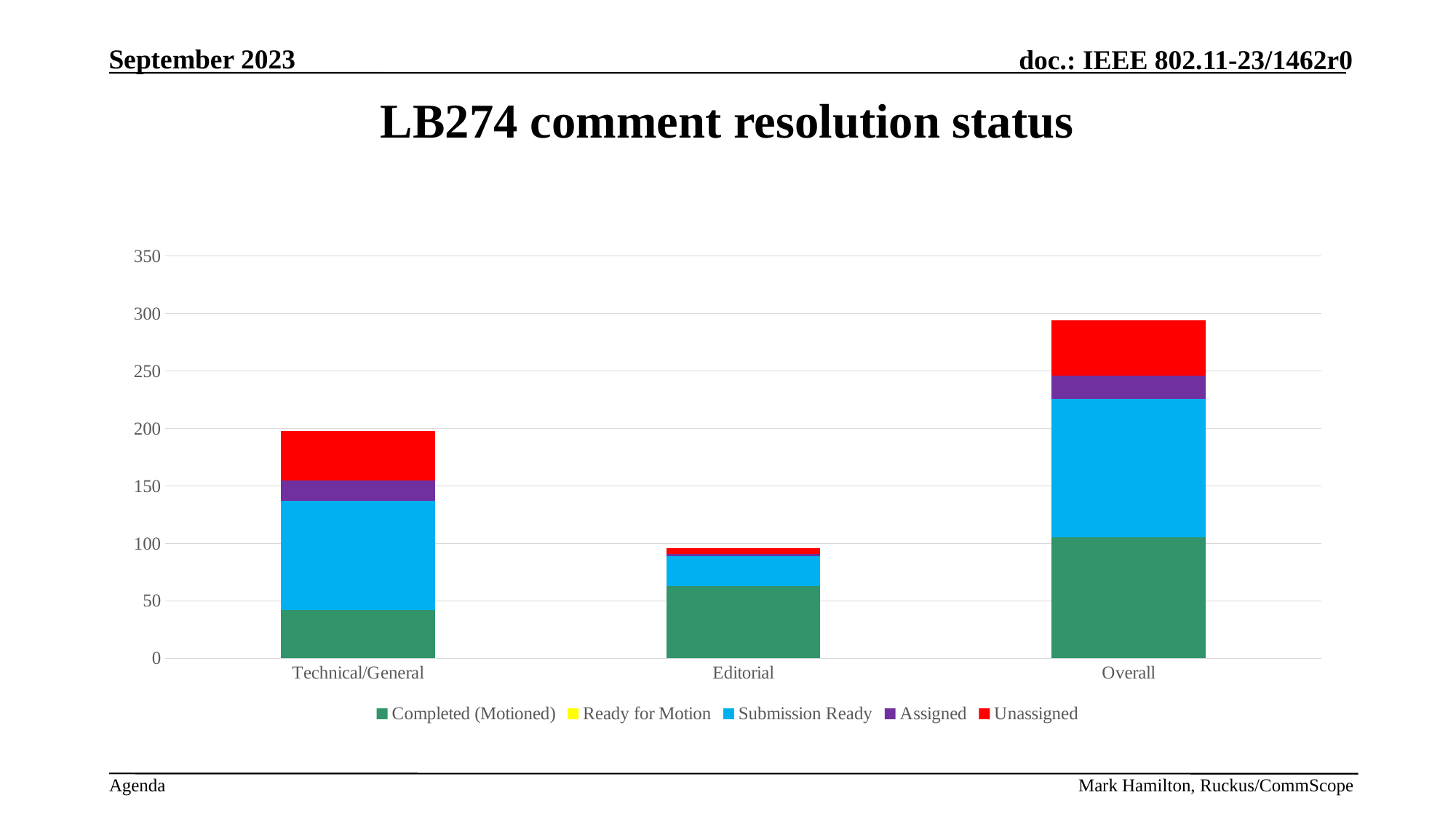
How many categories are shown on the x axis? 3 How many series does the legend list? 5 Which stacked bar is taller, Technical/General or Editorial? Technical/General Is the total height of the Technical/General bar greater or less than 150? greater Is the total height of the Editorial bar greater or less than 50? greater Which category has the tallest stacked bar? Overall Which series is shown in red in the legend? Unassigned Which category has the shortest stacked bar? Editorial What is the title of the chart? LB274 comment resolution status Is the Completed (Motioned) segment for Technical/General greater or less than 50? less What kind of chart is shown on the slide? stacked bar chart